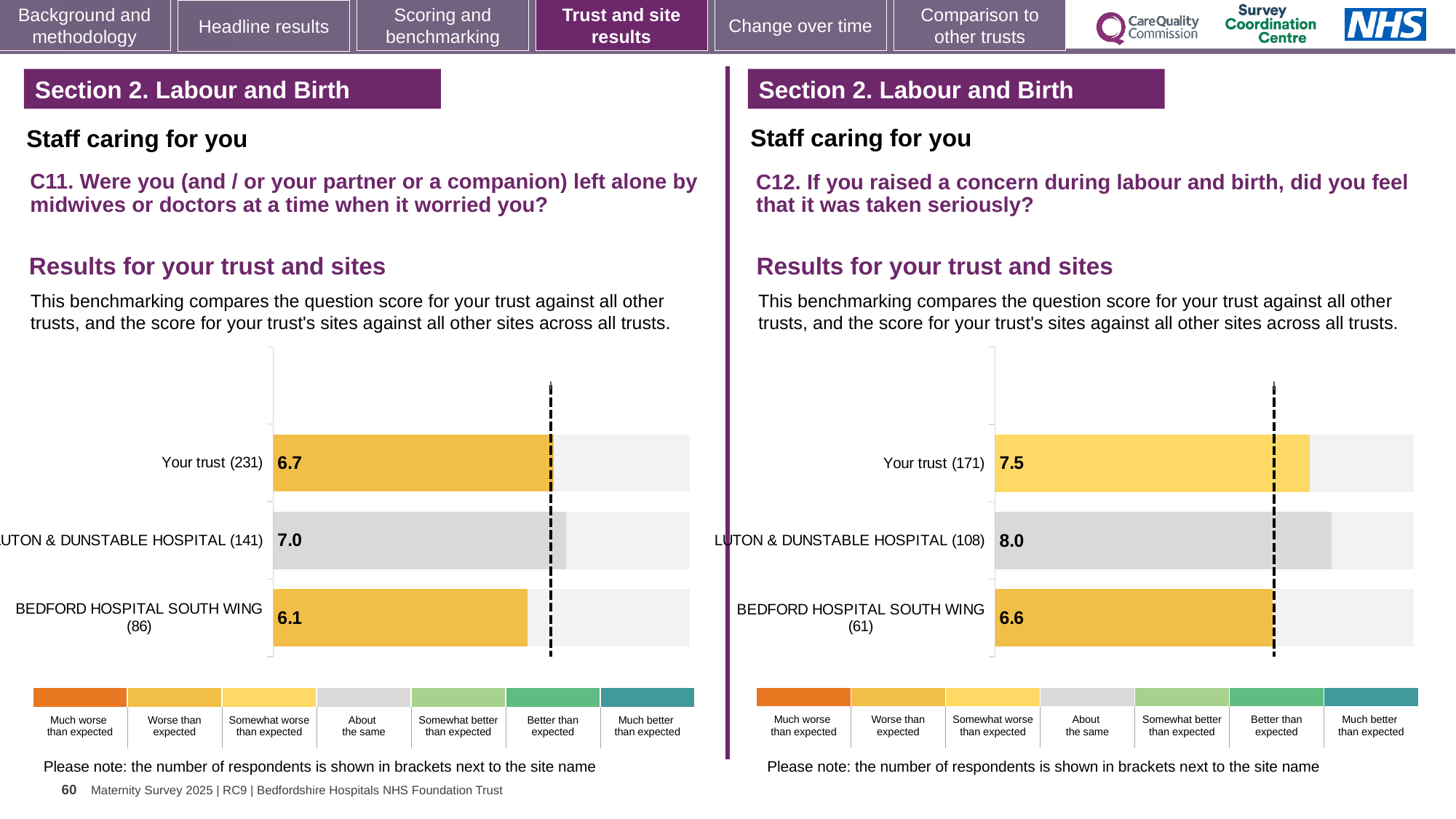
In the C12 chart on the right, what is the difference between the Your trust score and the BEDFORD HOSPITAL SOUTH WING score? 0.9 In the C12 chart on the right, what is the score for LUTON & DUNSTABLE HOSPITAL (108)? 8.0 In the C12 chart on the right, which site or trust has the lowest score? BEDFORD HOSPITAL SOUTH WING (61) In the C11 chart on the left, what is the score for Your trust (231)? 6.7 In the C12 chart on the right, what is the score for Your trust (171)? 7.5 What kind of chart is used for the C12 results on the right? Bar chart In the C11 chart on the left, what is the difference between the LUTON & DUNSTABLE HOSPITAL score and the BEDFORD HOSPITAL SOUTH WING score? 0.9 In the C11 chart on the left, how many respondents are shown in brackets for Your trust? 231 How many bars are plotted in the C11 chart on the left? 3 In the C11 chart on the left, what is the score for BEDFORD HOSPITAL SOUTH WING (86)? 6.1 In the C11 chart on the left, which site or trust has the highest score? LUTON & DUNSTABLE HOSPITAL (141) In the C12 chart on the right, which has the larger score: Your trust or BEDFORD HOSPITAL SOUTH WING? Your trust